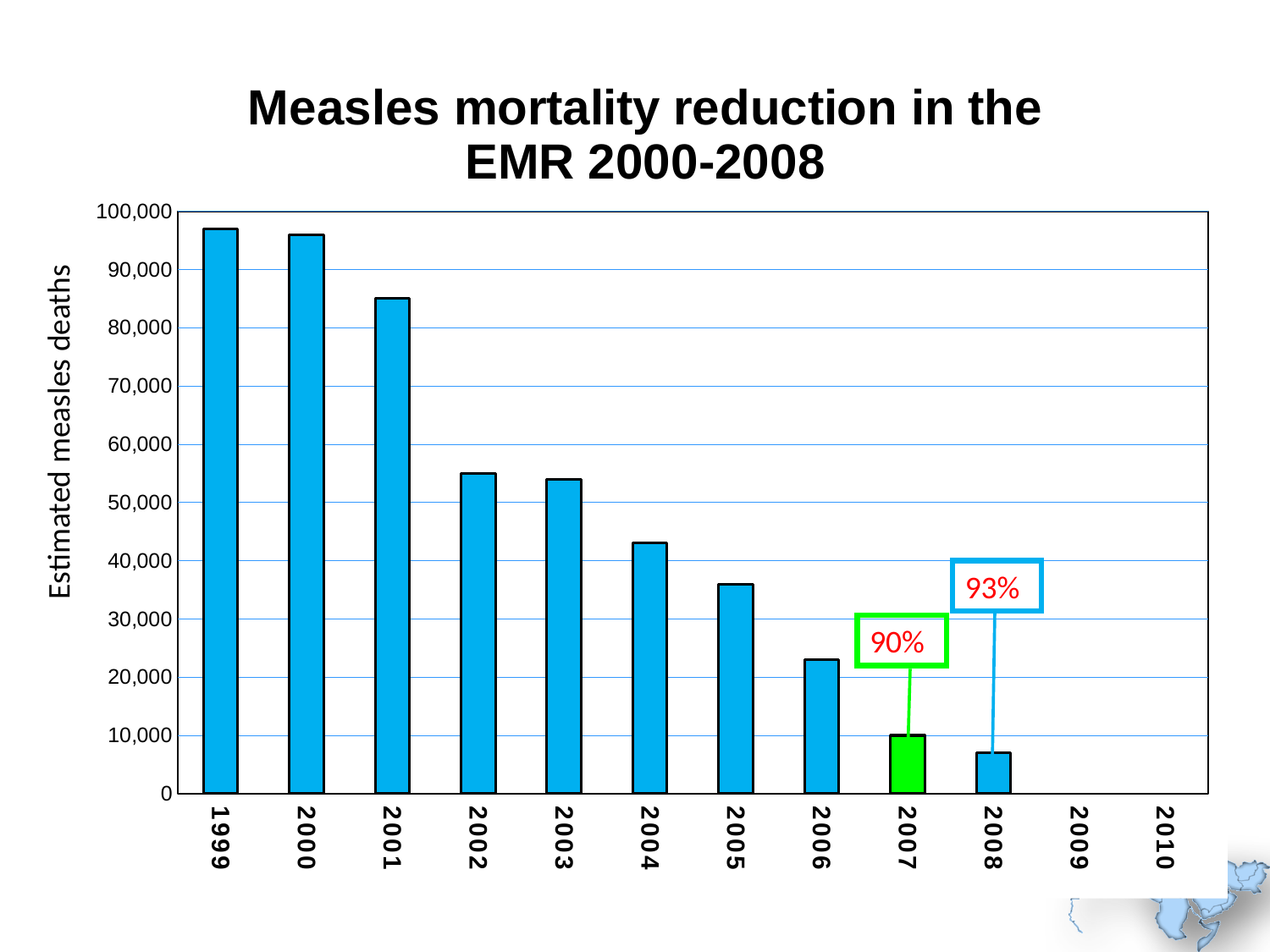
Do the estimated measles deaths rise or fall from 1999 to 2008? fall Which year has the larger value, 2001 or 2002? 2001 Which year has the lowest bar on the chart? 2008 Is the value for 2001 greater or less than 80,000? greater Is the value for 2006 greater or less than 20,000? greater Is the value for 1999 greater or less than 90,000? greater How many years on the x axis have a bar plotted? 10 What is the title of the chart? Measles mortality reduction in the EMR 2000-2008 What kind of chart is shown on the slide? bar chart What is the label on the vertical axis? Estimated measles deaths